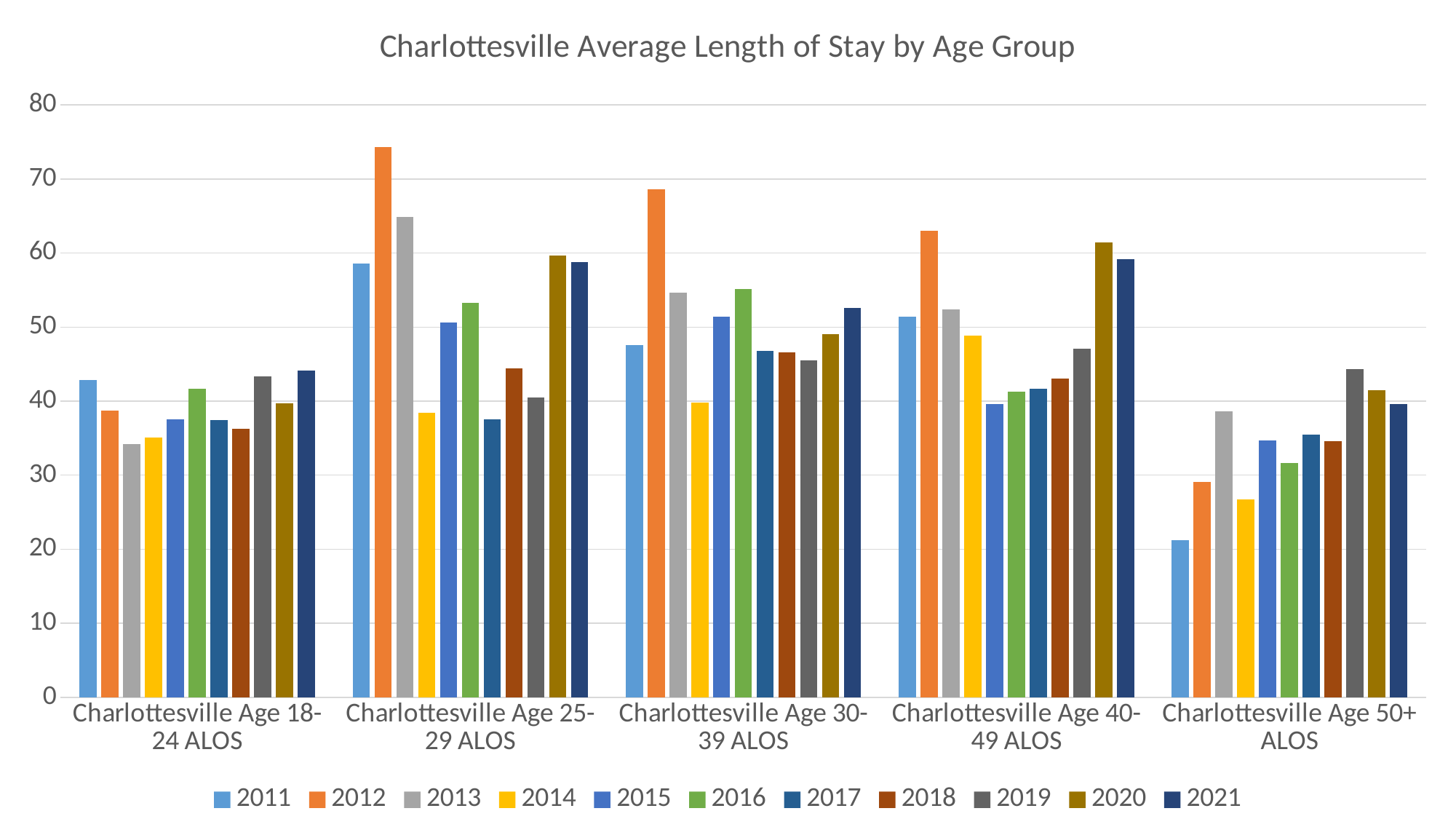
How many age group categories are shown on the x axis? 5 How many series (years) does the legend list? 11 Is the 2011 value for Charlottesville Age 50+ ALOS greater or less than 30? less Is the 2020 value for Charlottesville Age 40-49 ALOS greater or less than 60? greater Which age group has the highest 2012 bar? Charlottesville Age 25-29 ALOS Which age group has the lowest 2011 bar? Charlottesville Age 50+ ALOS For Charlottesville Age 40-49 ALOS, which is larger: the 2014 value or the 2016 value? 2014 For Charlottesville Age 30-39 ALOS, which is larger: the 2012 value or the 2013 value? 2012 Is the 2012 value for Charlottesville Age 25-29 ALOS greater or less than 70? greater What kind of chart is shown on the slide? Bar chart Within Charlottesville Age 50+ ALOS, which year has the lowest bar? 2011 What is the title of the chart? Charlottesville Average Length of Stay by Age Group